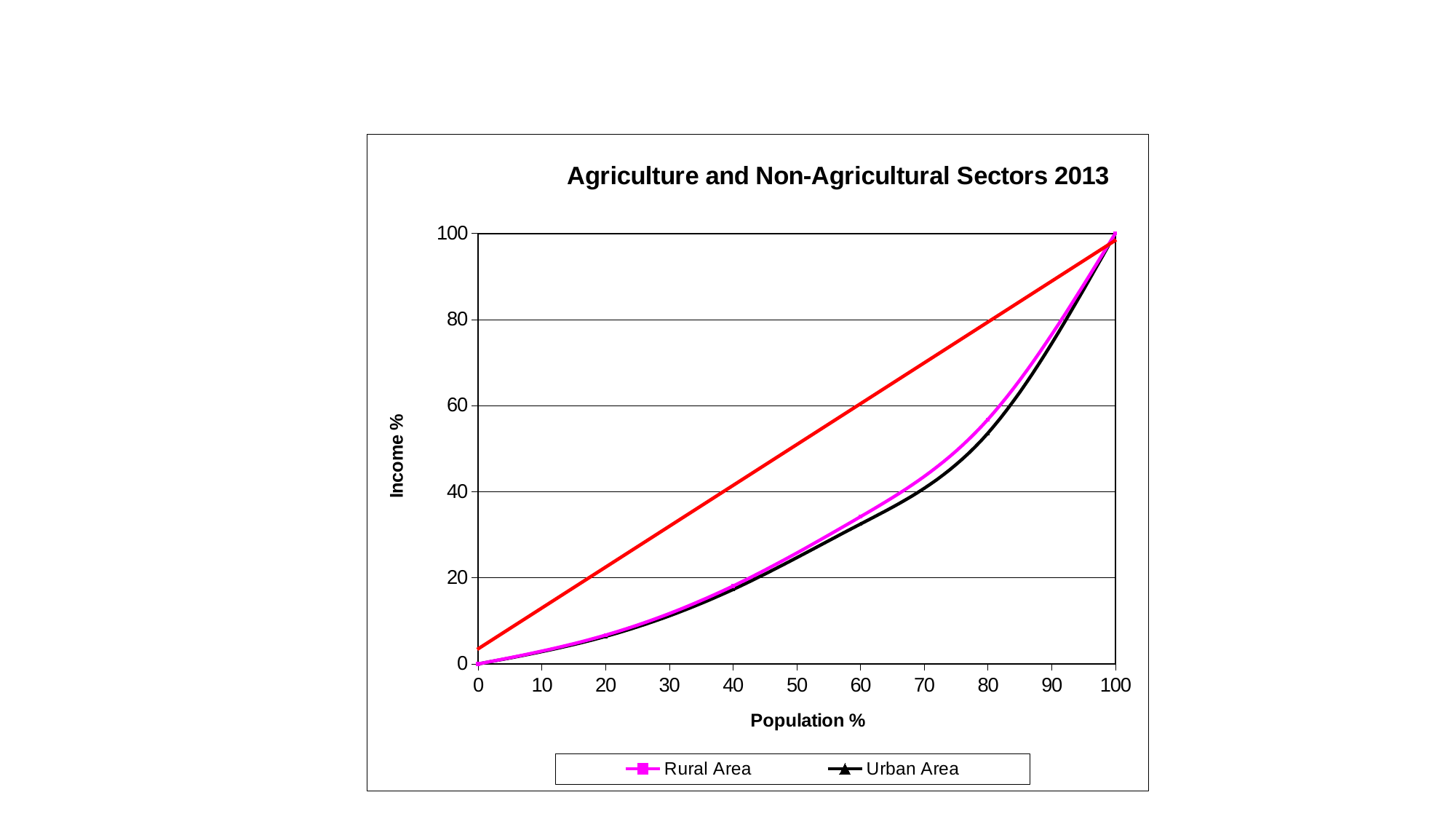
Is the Income % value for Urban Area at Population % 80 greater or less than 40? greater What kind of chart is shown on the slide? line chart What is the Income % value for Urban Area at Population % 0? 0 For Urban Area, is the Income % value larger at Population % 90 or at Population % 50? 90 Is the Income % value for Rural Area at Population % 50 greater or less than 40? less How many series does the chart legend list? 2 Is the Income % value for Urban Area at Population % 20 greater or less than 20? less What is the Income % value for Rural Area at Population % 100? 100 Do the Rural Area values rise or fall as Population % increases? rise What is the title of the chart? Agriculture and Non-Agricultural Sectors 2013 What is the label of the y axis? Income %